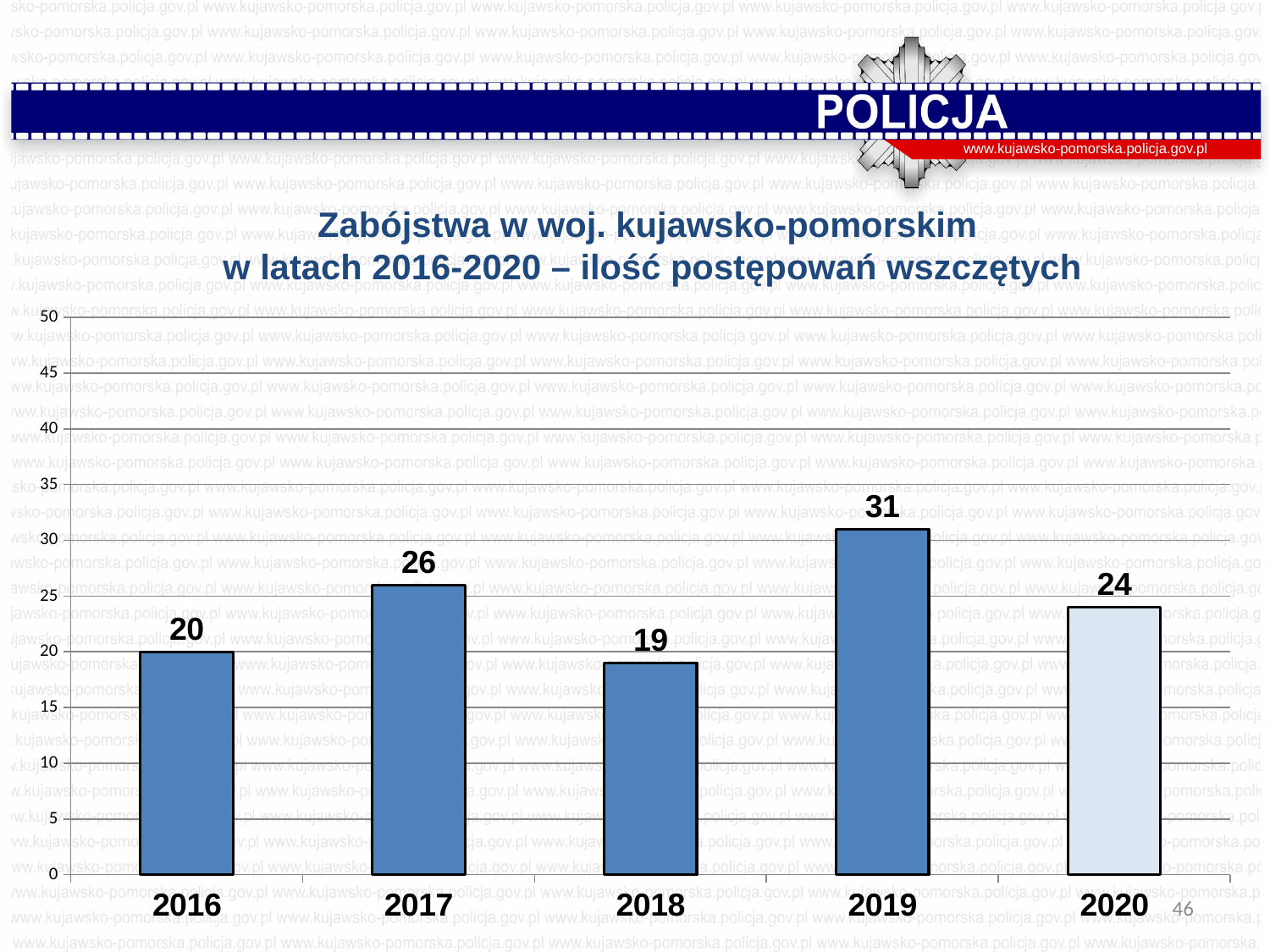
Which is larger, the value for 2017 or the value for 2020? 2017 What is the title of the chart? Zabójstwa w woj. kujawsko-pomorskim w latach 2016-2020 – ilość postępowań wszczętych Which year has the lowest value? 2018 What is the value for 2016? 20 What kind of chart is shown on the slide? bar chart What is the difference between the values for 2017 and 2016? 6 What is the value for 2019? 31 How many years are shown on the chart? 5 What is the value for 2020? 24 Which year has the highest value? 2019 What is the difference between the values for 2019 and 2018? 12 Is the value for 2019 greater or less than 30? greater